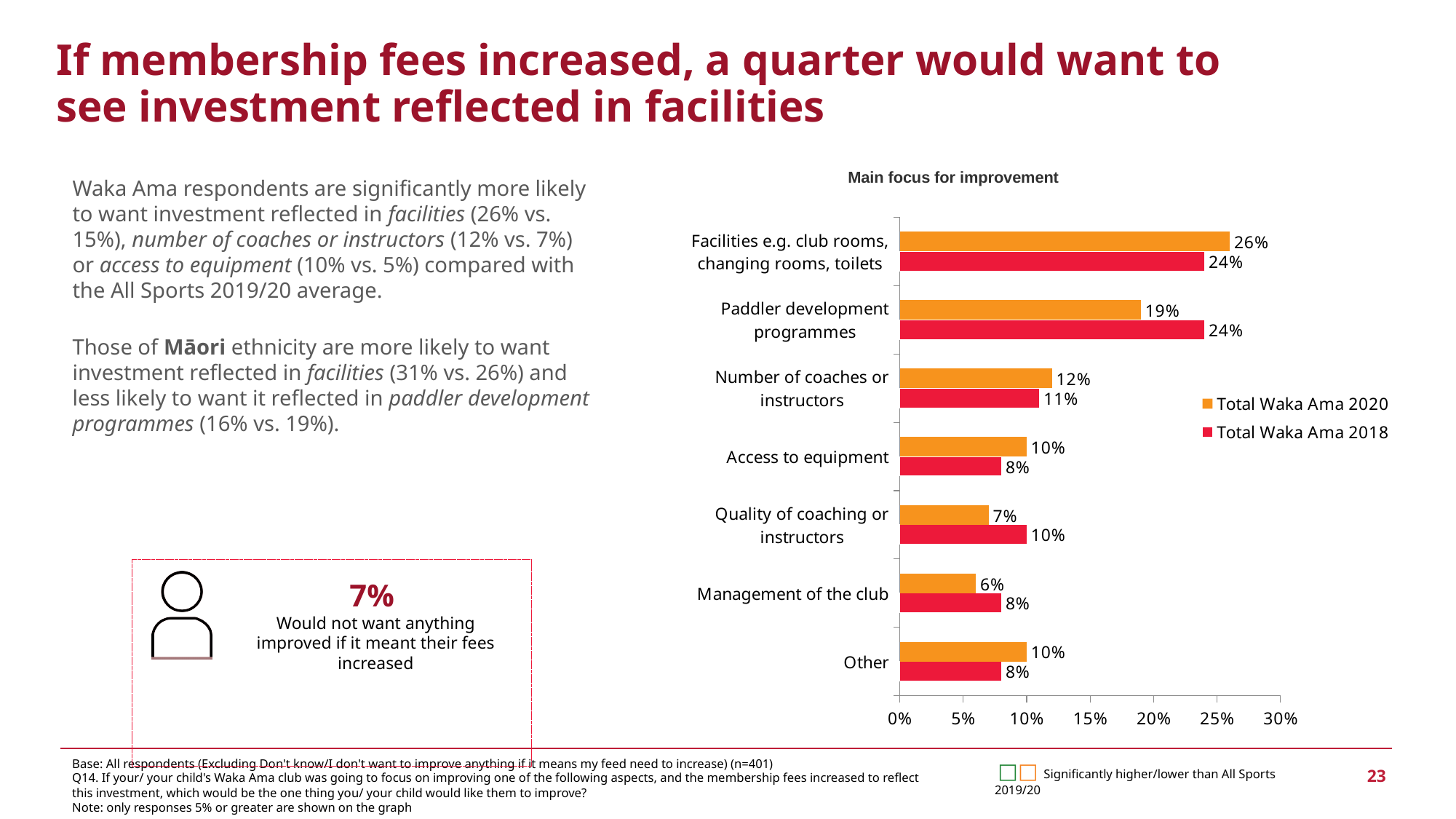
What is the Total Waka Ama 2018 value for Paddler development programmes? 24% How many series does the legend list? 2 What is the Total Waka Ama 2020 value for Management of the club? 6% What is the difference between the Total Waka Ama 2018 and Total Waka Ama 2020 values for Paddler development programmes? 5% What is the Total Waka Ama 2020 value for Facilities e.g. club rooms, changing rooms, toilets? 26% For Quality of coaching or instructors, which is larger: the Total Waka Ama 2020 value or the Total Waka Ama 2018 value? Total Waka Ama 2018 Which category has the highest Total Waka Ama 2020 value? Facilities e.g. club rooms, changing rooms, toilets What is the title of the chart? Main focus for improvement What kind of chart is shown on the slide? Bar chart How many categories are shown on the chart? 7 Is the Total Waka Ama 2020 value for Number of coaches or instructors greater or less than 10%? greater Which category has the lowest Total Waka Ama 2020 value? Management of the club